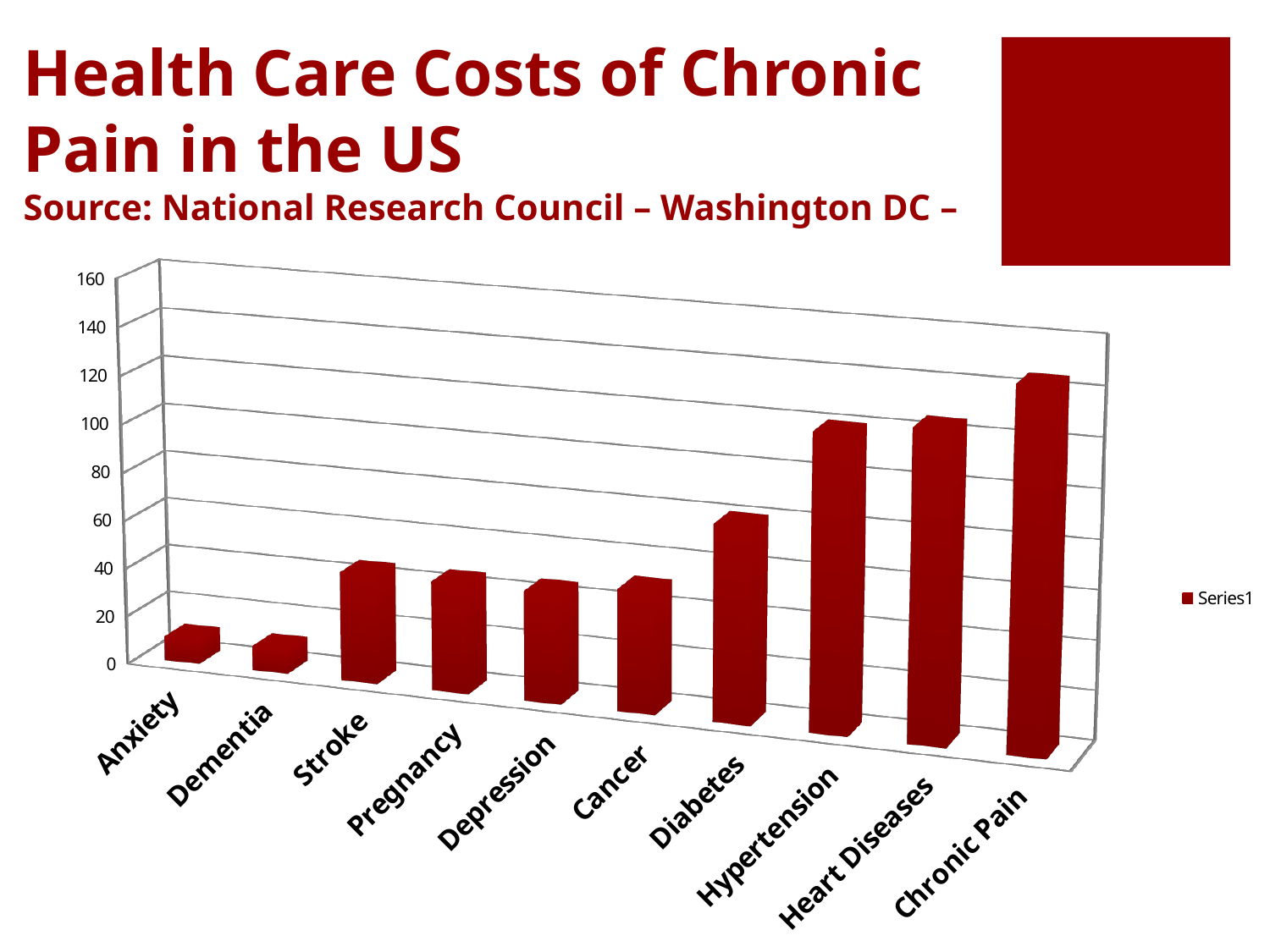
Is the value for Diabetes greater or less than 40? greater How many series does the chart's legend list? 1 What is the name of the series listed in the chart's legend? Series1 Which is larger, the value for Diabetes or the value for Stroke? Diabetes What kind of chart is shown on the slide? bar chart Which category has the highest bar in the chart? Chronic Pain How many categories are shown on the x axis of the chart? 10 Is the value for Stroke greater or less than 60? less Is the value for Anxiety greater or less than 20? less Do the bar values generally rise or fall from left to right along the x axis? rise Which is larger, the value for Chronic Pain or the value for Hypertension? Chronic Pain